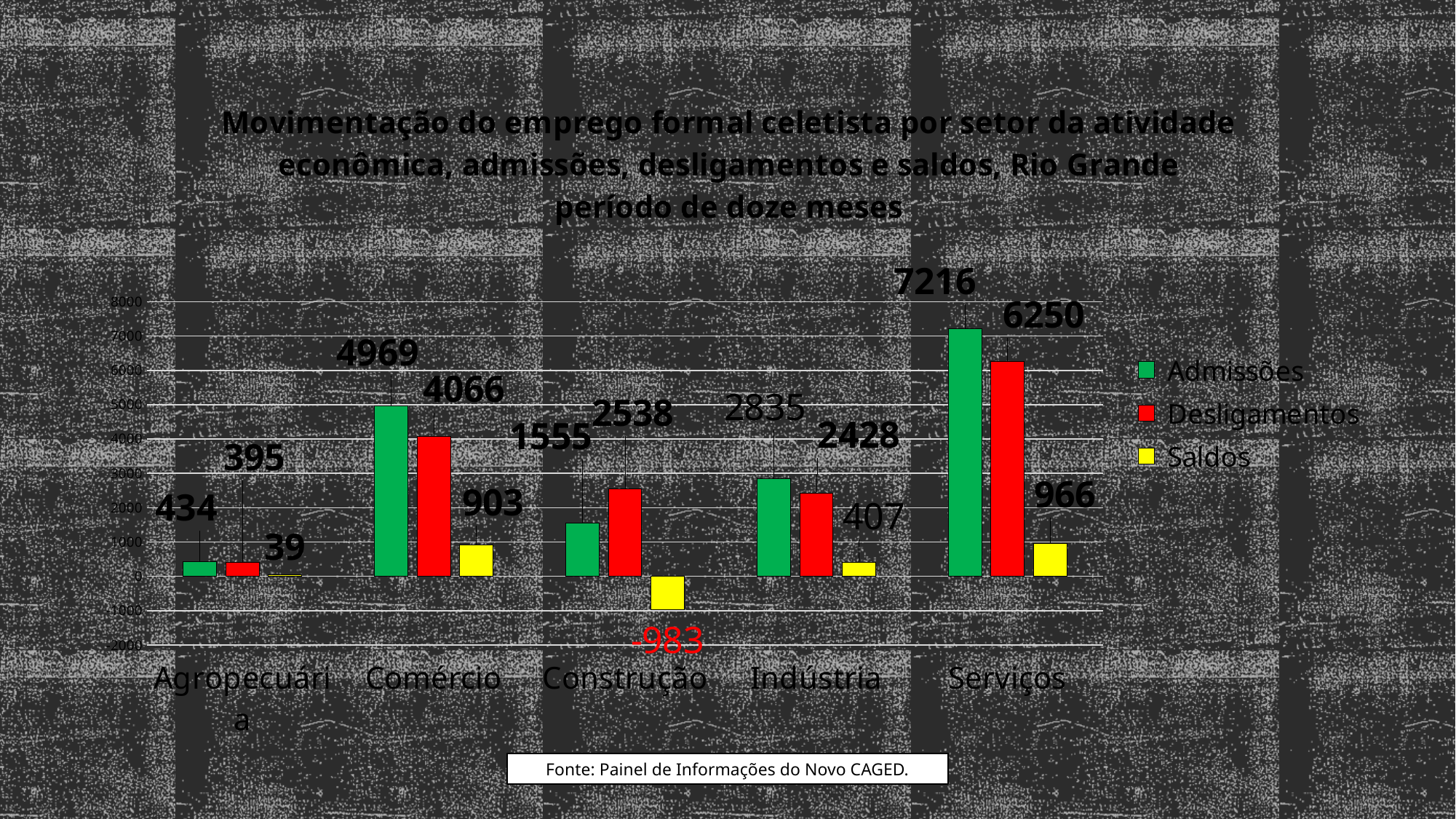
What is the value of Desligamentos for Comércio? 4066 How many series does the legend list? 3 What is the value of Saldos for Agropecuária? 39 What is the difference between Admissões and Desligamentos for Indústria? 407 What is the value of Admissões for Serviços? 7216 What kind of chart is shown on the slide? bar chart Is the value of Desligamentos for Serviços greater or less than 6000? greater Which sector has the highest value of Admissões? Serviços Which is larger for Construção, Admissões or Desligamentos? Desligamentos What is the value of Saldos for Construção? -983 How many sectors are shown on the x axis? 5 Which sector has the lowest value of Saldos? Construção